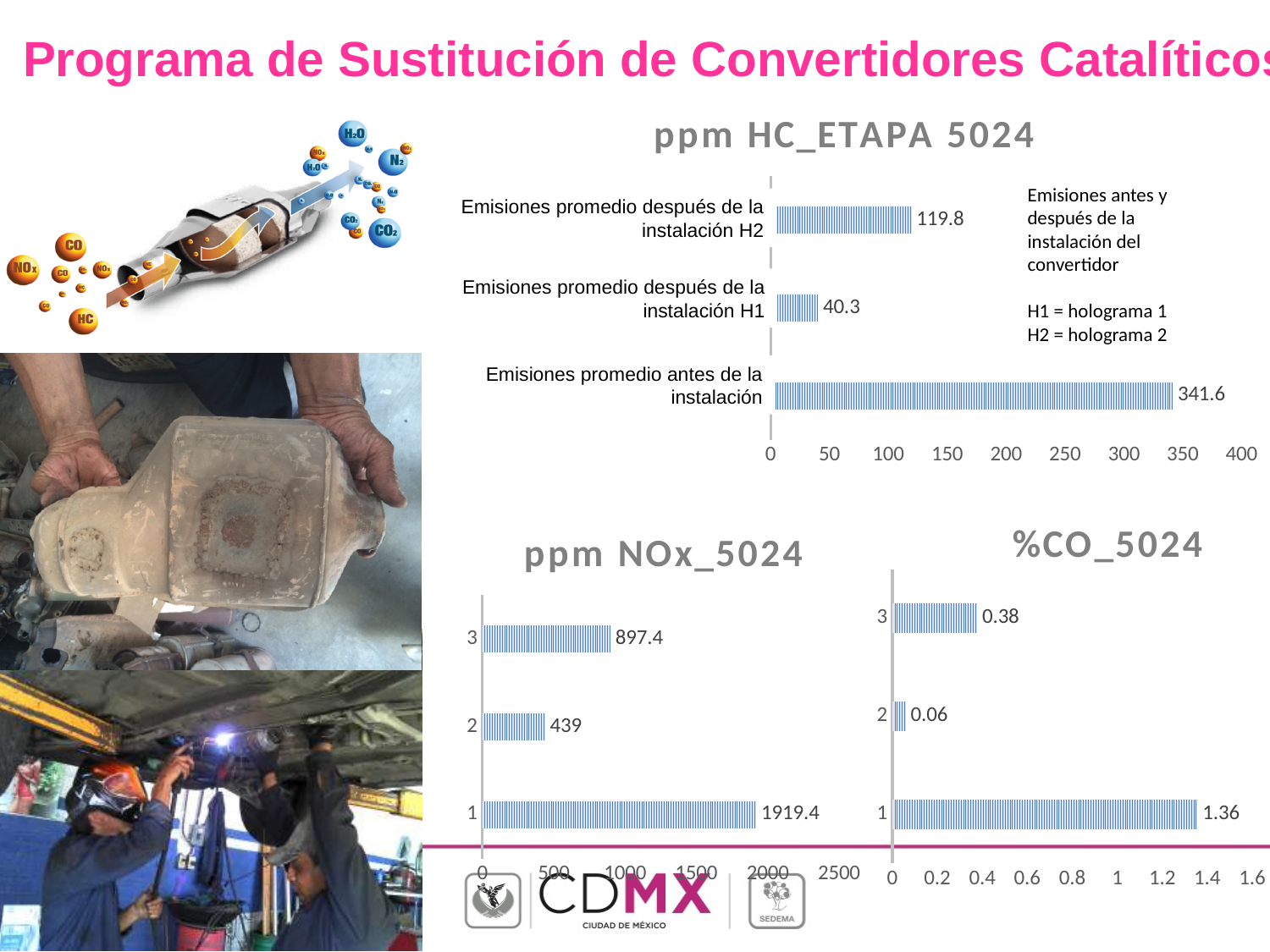
In the '%CO_5024' chart, which is larger, the value for category 3 or the value for category 1? category 1 In the 'ppm HC_ETAPA 5024' chart, how many categories are plotted? 3 In the 'ppm HC_ETAPA 5024' chart, which category has the highest value? Emisiones promedio antes de la instalación In the '%CO_5024' chart, what is the difference between the values for category 1 and category 3? 0.98 In the 'ppm NOx_5024' chart, what is the value for category 1? 1919.4 In the 'ppm HC_ETAPA 5024' chart, what is the difference between 'Emisiones promedio después de la instalación H2' and 'Emisiones promedio después de la instalación H1'? 79.5 In the 'ppm HC_ETAPA 5024' chart, what is the value for 'Emisiones promedio antes de la instalación'? 341.6 In the '%CO_5024' chart, what is the value for category 2? 0.06 In the 'ppm HC_ETAPA 5024' chart, what is the value for 'Emisiones promedio después de la instalación H1'? 40.3 In the 'ppm NOx_5024' chart, is the value for category 3 greater or less than 1000? less In the 'ppm NOx_5024' chart, which category has the lowest value? 2 What kind of chart is 'ppm NOx_5024'? bar chart